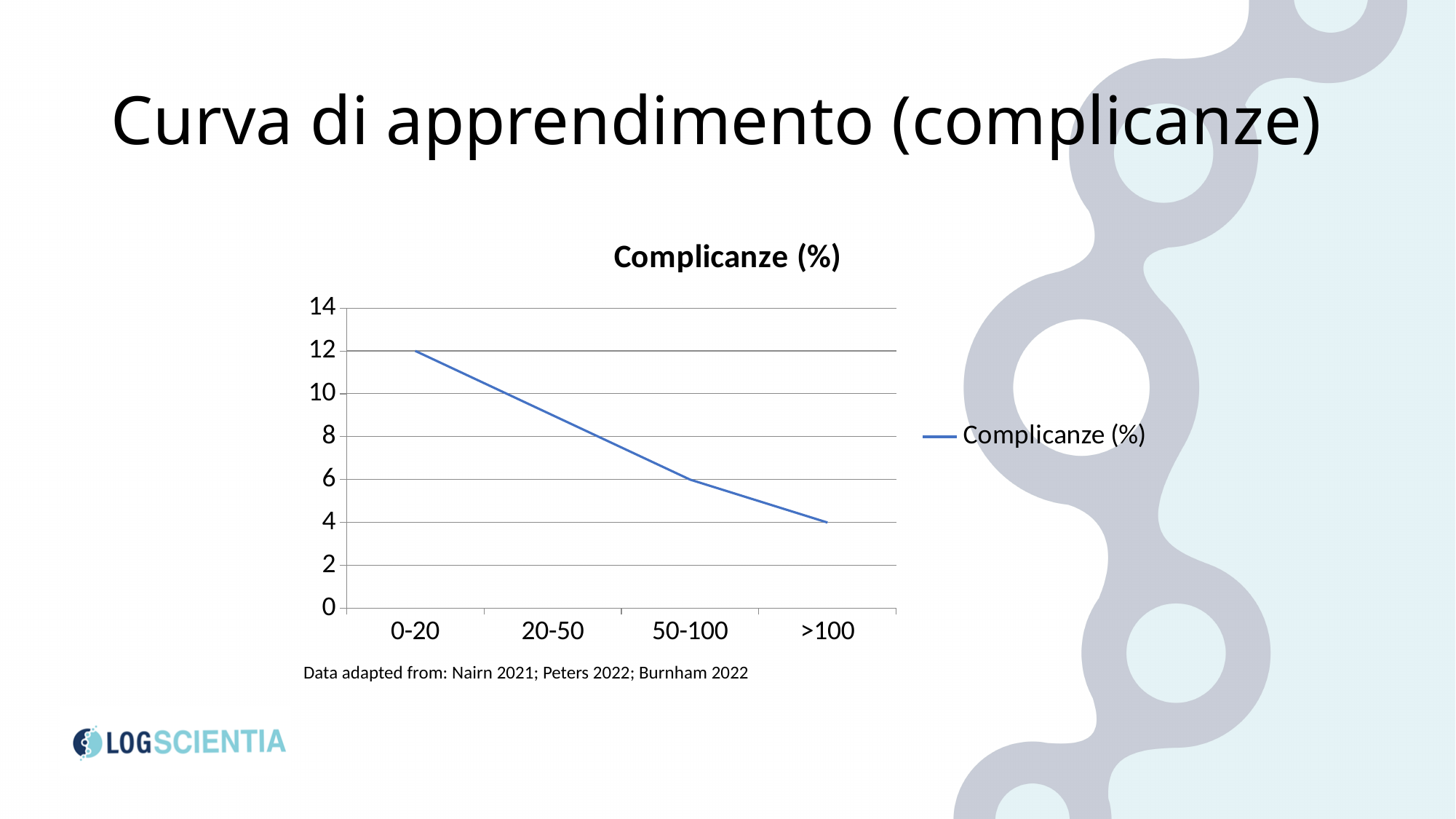
What is the value for the 50-100 category? 6 What type of chart is shown on the slide? line chart What is the value for the >100 category? 4 How many series does the legend list? 1 What is the title of the chart? Complicanze (%) Is the value for the 20-50 category greater or less than 10? less How many categories are shown on the x axis? 4 Which category has the lowest value? >100 What is the value for the 0-20 category? 12 Is the value for the 20-50 category greater or less than 8? greater Which category has the highest value? 0-20 What is the difference between the value for 0-20 and the value for >100? 8